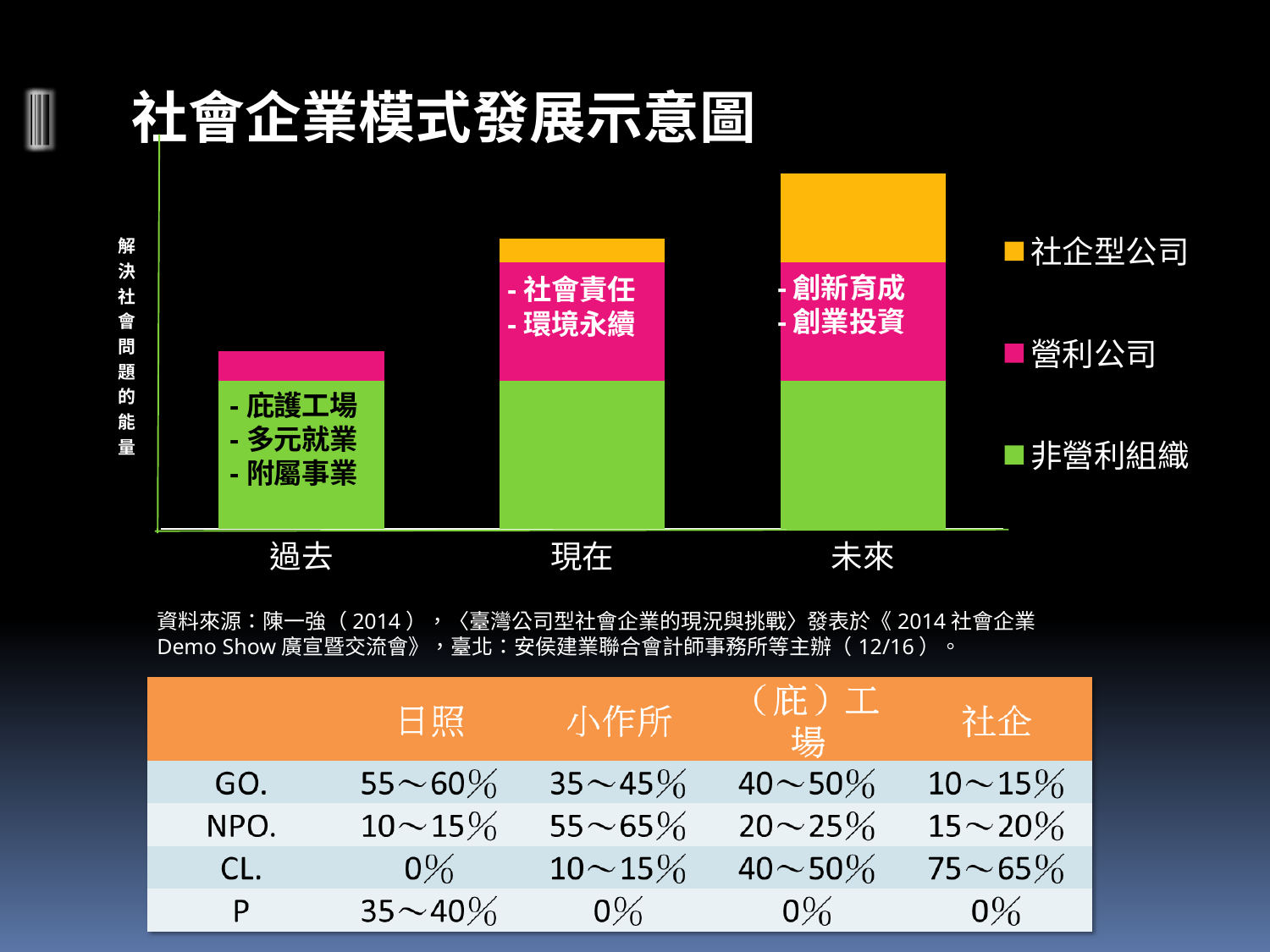
Do the total bar heights rise or fall moving from 過去 to 未來 along the x axis? Rise Which category's bar has no 社企型公司 (orange) segment? 過去 What is the title of the chart? 社會企業模式發展示意圖 Which category has the larger 社企型公司 (orange) segment, 現在 or 未來? 未來 Which stacked bar is taller in total, 現在 or 未來? 未來 Which category has the shortest stacked bar overall? 過去 How many series does the chart's legend list? 3 Which legend entry is shown in green? 非營利組織 How many categories are shown along the x axis of the chart? 3 Which category has the tallest stacked bar overall? 未來 What kind of chart is shown on the slide? Stacked bar chart